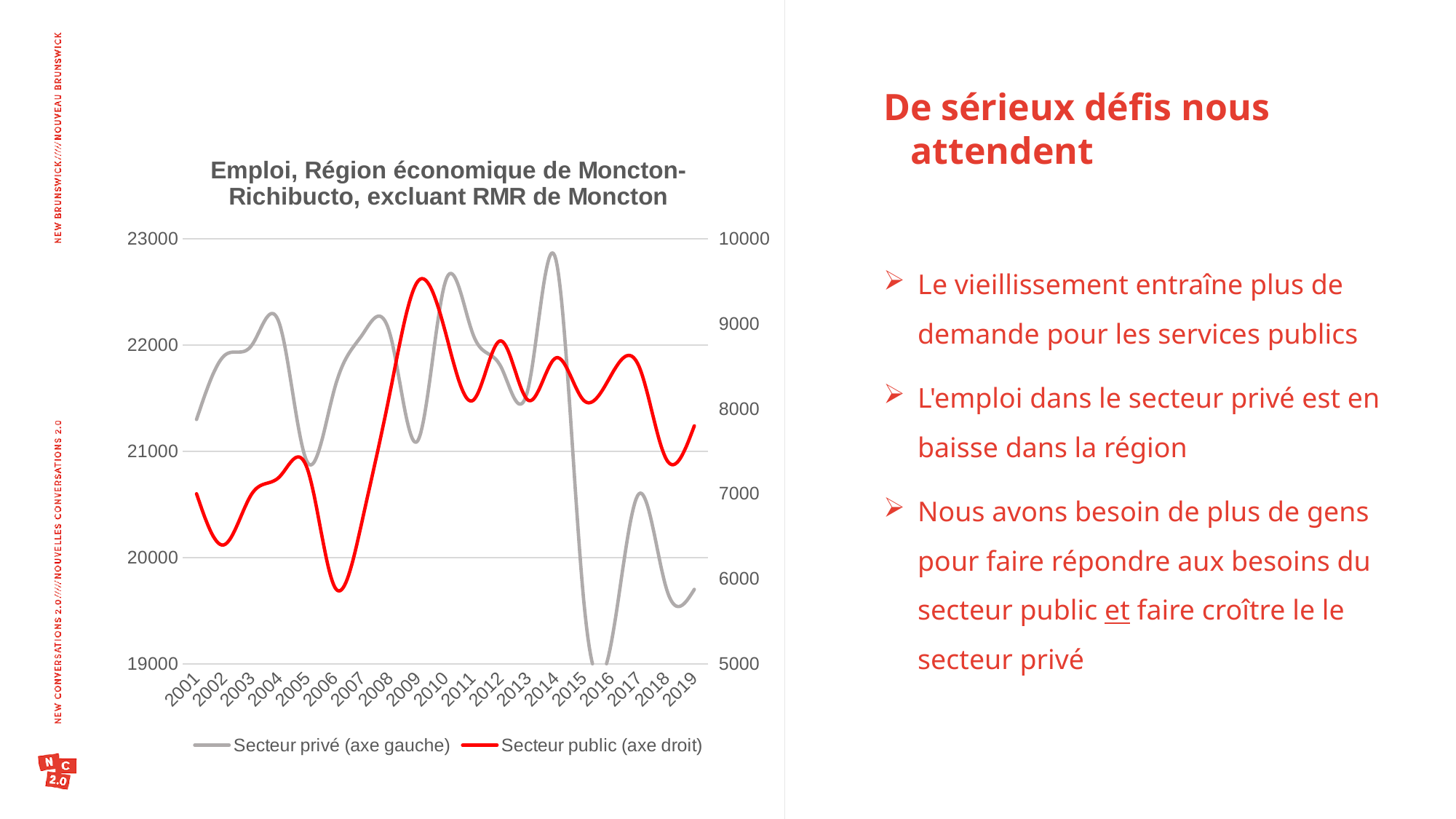
In which year does the Secteur privé series reach its lowest value? 2016 In which year does the Secteur public series reach its lowest value? 2006 Is the value for Secteur privé in 2014 greater or less than 22000? greater Overall, does the Secteur privé series rise or fall from 2001 to 2019? Fall How many series does the chart legend list? 2 Is the value for Secteur public in 2009 greater or less than 9000? greater Is the value for Secteur privé in 2016 greater or less than 20000? less What kind of chart is shown on the slide? Line chart In which year does the Secteur public series reach its highest value? 2009 How many years are shown along the x axis of the chart? 19 What is the title of the chart? Emploi, Région économique de Moncton-Richibucto, excluant RMR de Moncton Which series is drawn in red on the chart? Secteur public (axe droit)